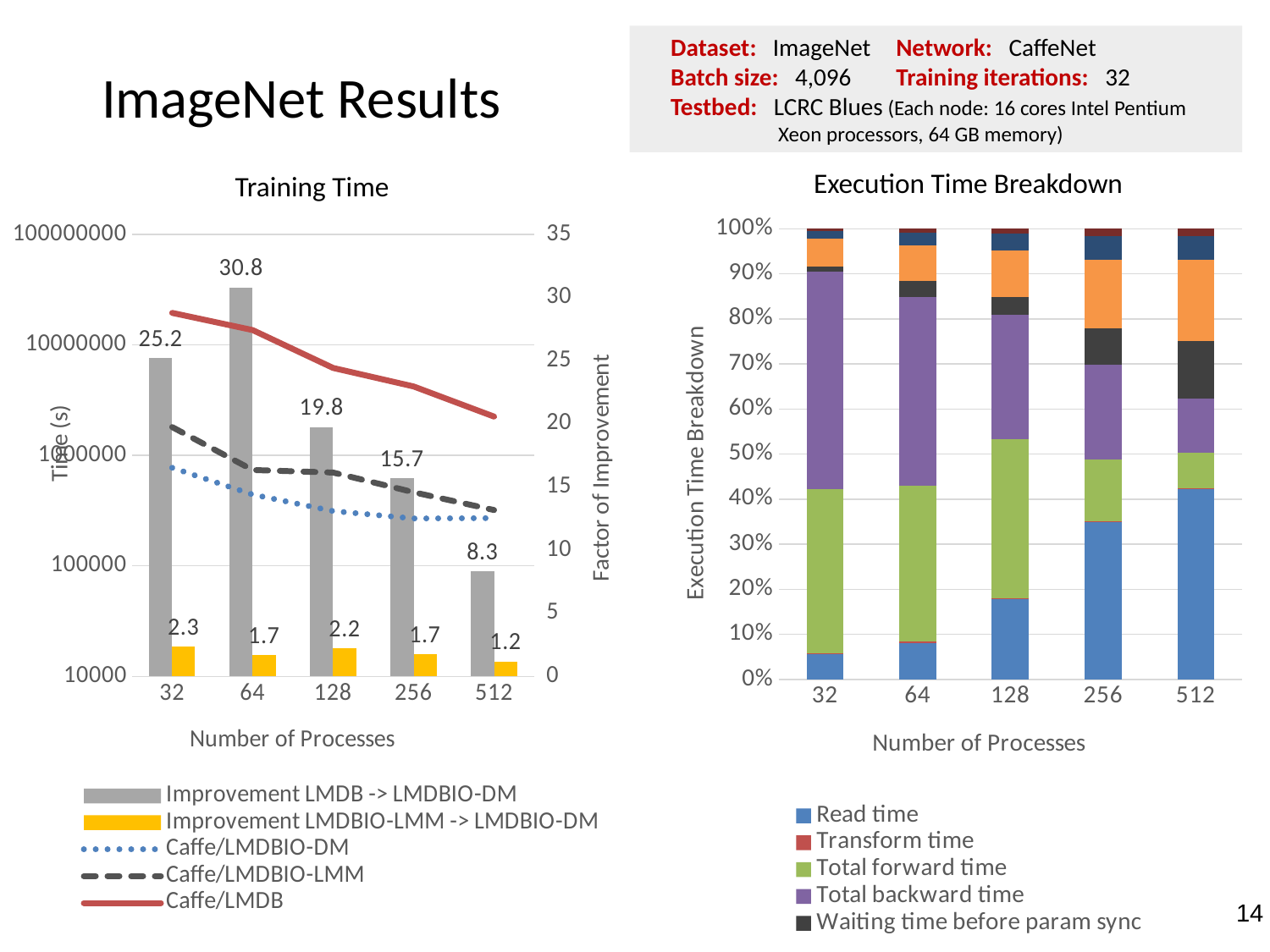
In the Execution Time Breakdown chart, is the Read time share at 32 processes greater or less than 10%? less In the Execution Time Breakdown chart, is the Read time share at 512 processes greater or less than 40%? greater In the Training Time chart, which has the larger Improvement LMDB -> LMDBIO-DM value, 128 or 256 processes? 128 In the Training Time chart, what is the difference between the Improvement LMDB -> LMDBIO-DM values at 64 and 512 processes? 22.5 In the Training Time chart, how many series does the legend list? 5 In the Training Time chart, at which number of processes is Improvement LMDB -> LMDBIO-DM lowest? 512 In the Training Time chart, what is the value of Improvement LMDB -> LMDBIO-DM at 64 processes? 30.8 How many numbers of processes are shown on the x axis of the Execution Time Breakdown chart? 5 In the Training Time chart, does the Caffe/LMDB line rise or fall as the number of processes increases? fall What kind of chart is the Execution Time Breakdown chart? stacked bar chart In the Training Time chart, what is the value of Improvement LMDBIO-LMM -> LMDBIO-DM at 512 processes? 1.2 In the Training Time chart, at which number of processes is Improvement LMDB -> LMDBIO-DM highest? 64